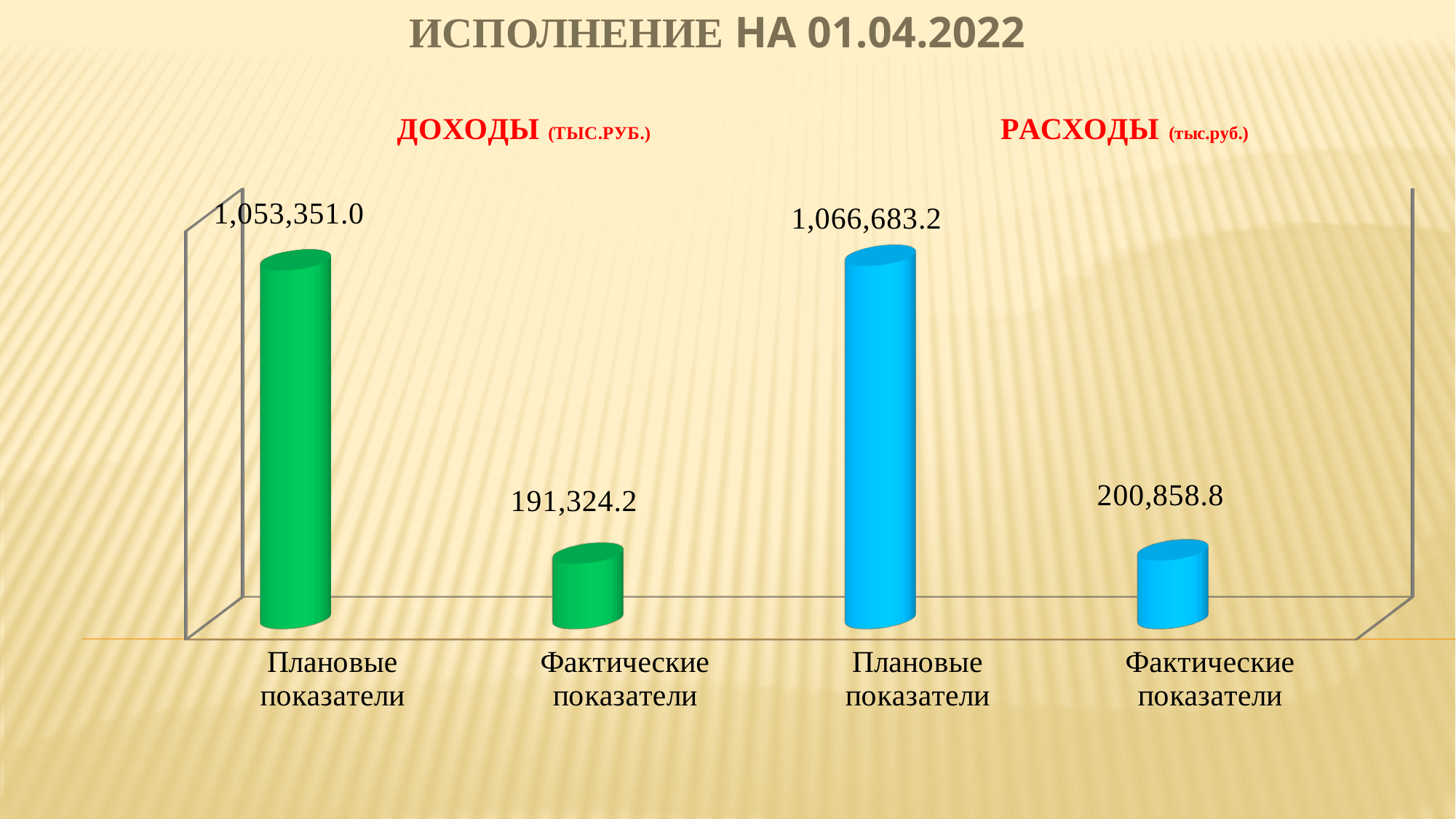
What kind of chart is shown on the slide? Bar chart How many bars are plotted on the chart? 4 What colour are the bars under РАСХОДЫ? Blue What is the difference between the planned and actual indicators under ДОХОДЫ? 862,026.8 What is the difference between the planned and actual indicators under РАСХОДЫ? 865,824.4 What is the value of the planned indicators (Плановые показатели) bar under РАСХОДЫ? 1,066,683.2 What is the value of the planned indicators (Плановые показатели) bar under ДОХОДЫ? 1,053,351.0 What is the value of the actual indicators (Фактические показатели) bar under ДОХОДЫ? 191,324.2 Which is larger: the actual indicators under ДОХОДЫ or the actual indicators under РАСХОДЫ? Actual indicators under РАСХОДЫ (200,858.8) Which bar on the chart has the lowest value? Фактические показатели under ДОХОДЫ (191,324.2) What is the value of the actual indicators (Фактические показатели) bar under РАСХОДЫ? 200,858.8 Which bar on the chart has the highest value? Плановые показатели under РАСХОДЫ (1,066,683.2)